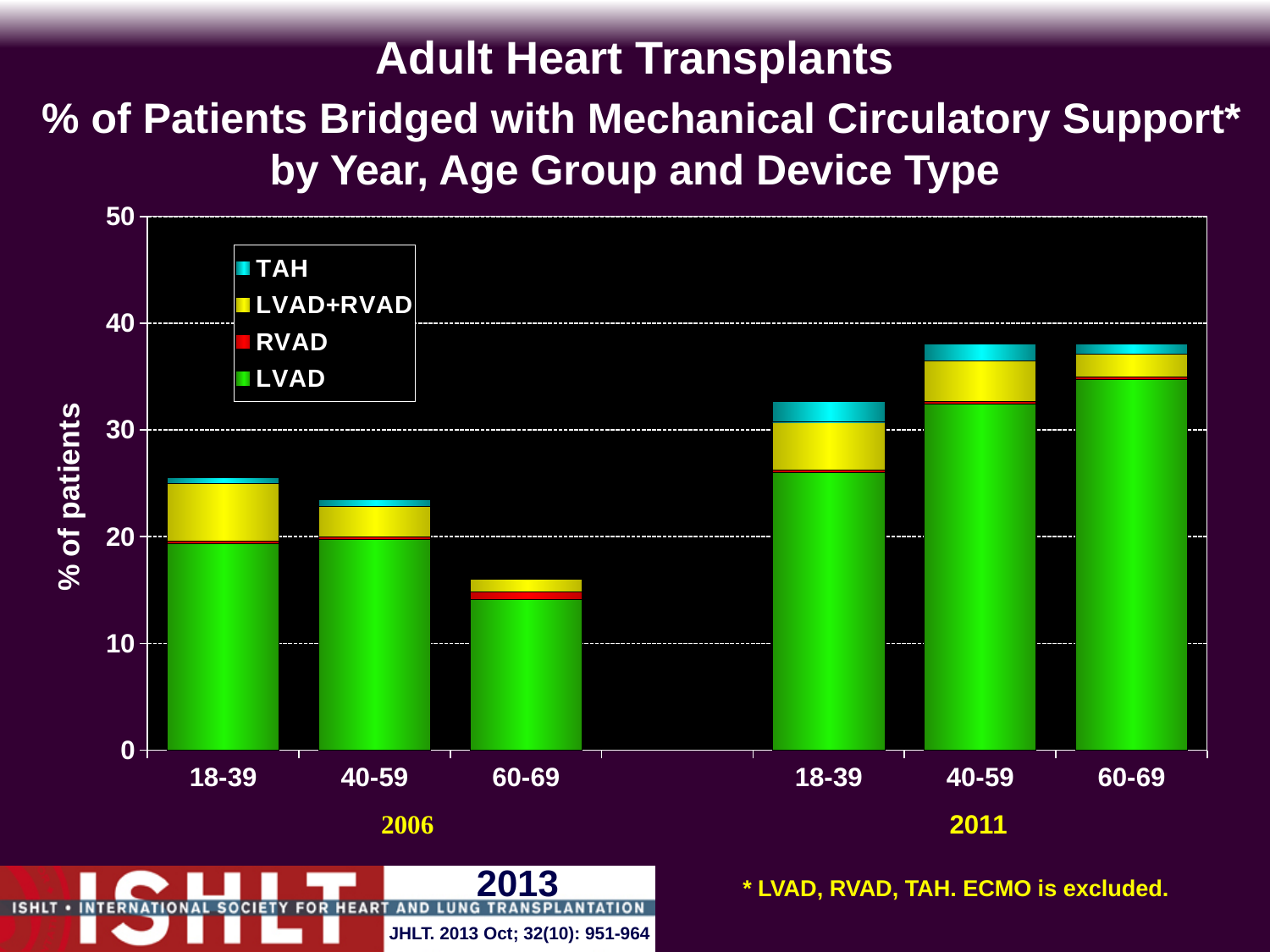
How many series does the legend list? 4 What kind of chart is shown on the slide? Stacked bar chart Which is larger: the total for the 18-39 age group in 2006 or the total for the 18-39 age group in 2011? 18-39 in 2011 Which series is shown in green in the legend? LVAD Is the total value for the 60-69 age group in 2006 greater or less than 20? less Is the total value for the 18-39 age group in 2006 greater or less than 20? greater Within 2006, do the bar totals rise or fall as the age group increases from 18-39 to 60-69? fall Is the total value for the 40-59 age group in 2011 greater or less than 40? less What is the label on the y axis? % of patients How many bars are plotted in the chart? 6 Which bar has the lowest total % of patients? 60-69 in 2006